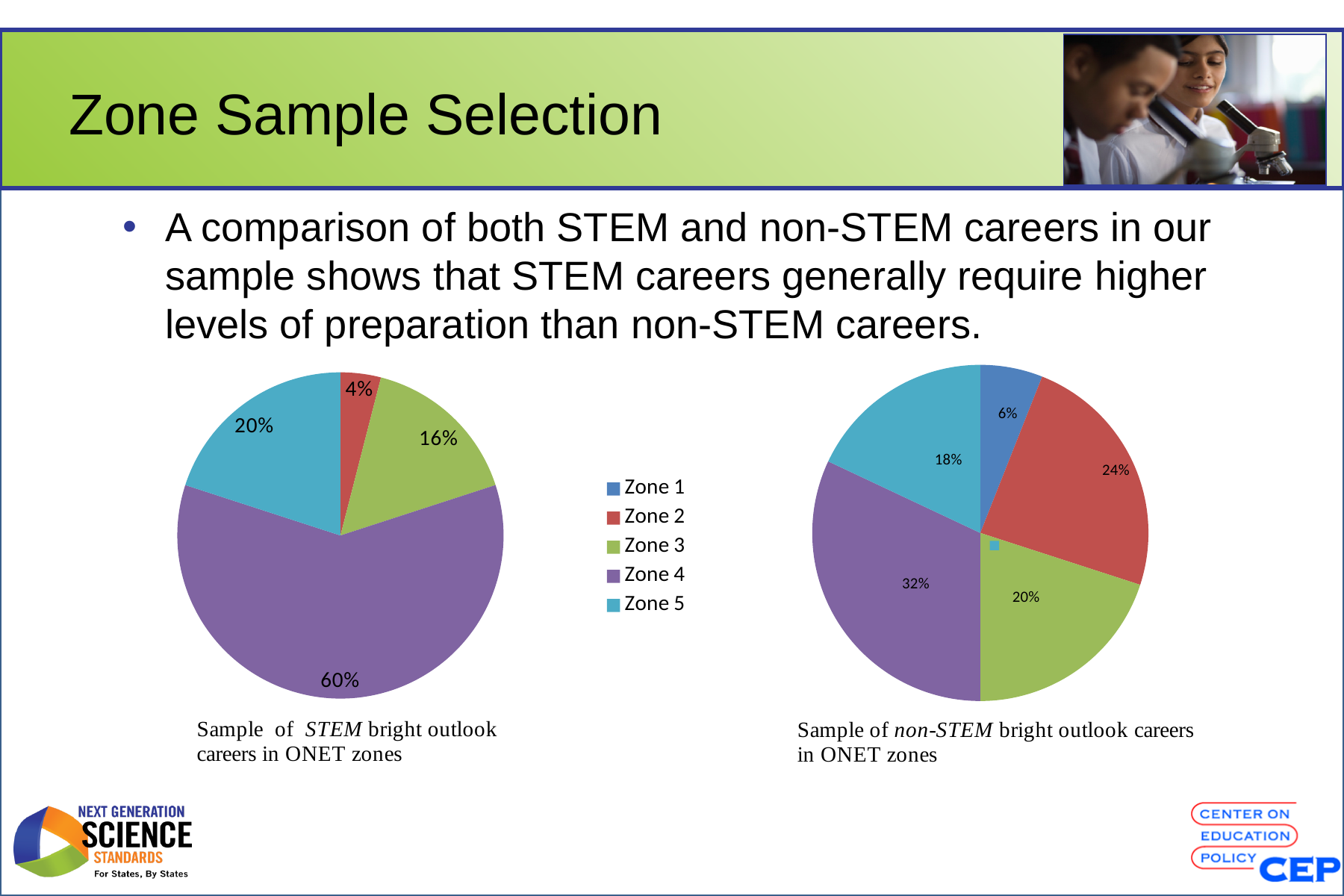
In the STEM bright outlook careers pie chart, which labelled zone has the smallest share? Zone 2 In the non-STEM bright outlook careers pie chart, which zone has the smallest share? Zone 1 In the non-STEM bright outlook careers pie chart, which zone has the largest share? Zone 4 In the STEM bright outlook careers pie chart, what share is Zone 3? 16% How many entries does the legend list? 5 Which colour represents Zone 5 in the legend? Teal (light blue) In the STEM bright outlook careers pie chart, what share is Zone 4? 60% What kind of chart is used for the STEM bright outlook careers sample? Pie chart What is the difference between the Zone 4 share in the STEM pie chart and the Zone 4 share in the non-STEM pie chart? 28% In the non-STEM bright outlook careers pie chart, what share is Zone 1? 6% In the non-STEM bright outlook careers pie chart, what share is Zone 2? 24% In the non-STEM bright outlook careers pie chart, which is larger, Zone 2 or Zone 3? Zone 2